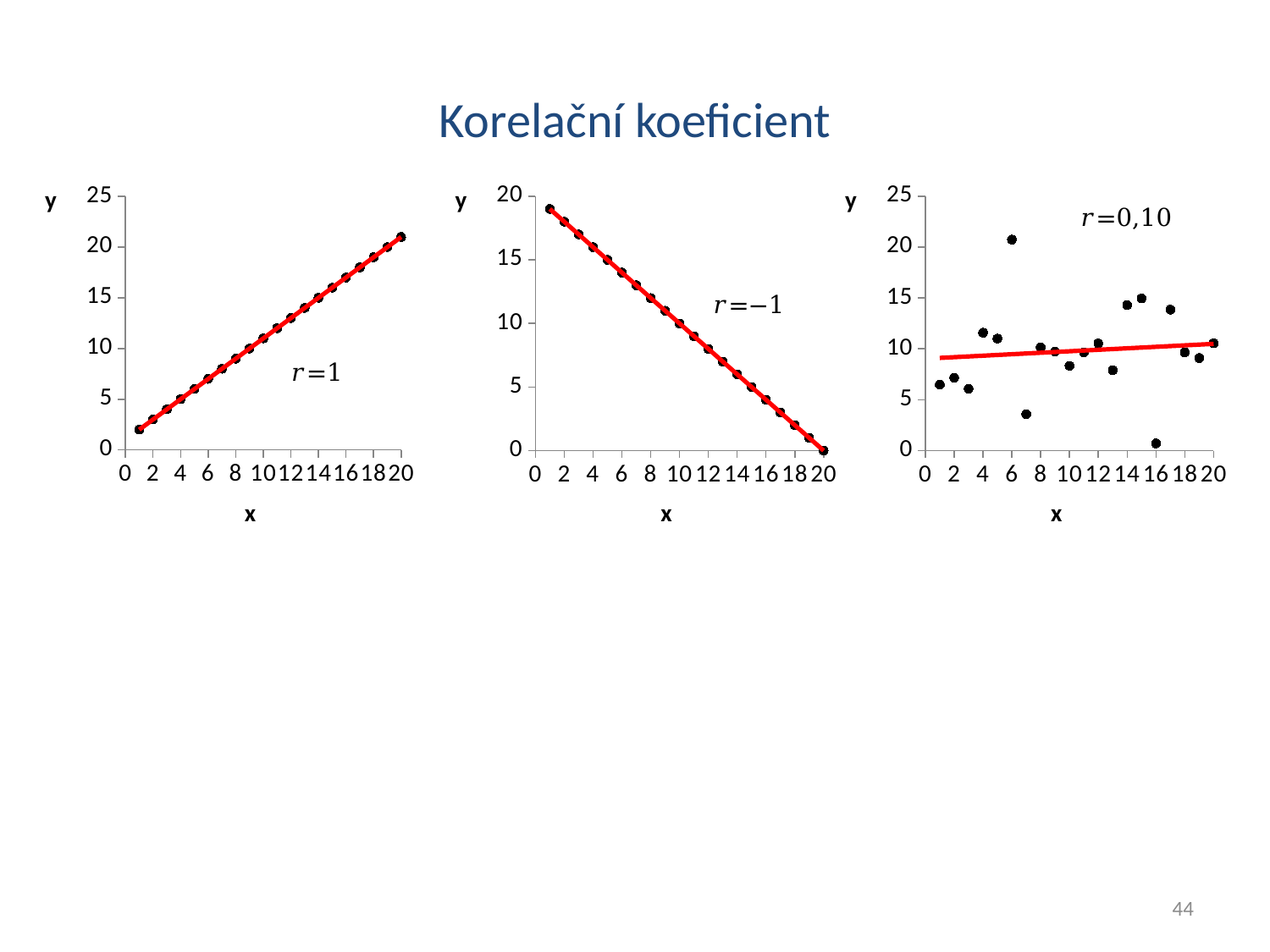
In the left chart (r=1), do the y values rise or fall as x increases? rise In the right chart (r=0,10), at which x value is the highest y value plotted? 6 What kind of chart is the left chart (r=1)? scatter chart What correlation coefficient is annotated on the right chart? r=0,10 In the right chart (r=0,10), which point has a larger y value: the one at x=6 or the one at x=7? x=6 In the middle chart (r=-1), do the y values rise or fall as x increases? fall In the middle chart (r=-1), is the y value at x=18 greater or less than 5? less In the middle chart (r=-1), is the y value at x=2 greater or less than 15? greater In the right chart (r=0,10), is the y value at x=16 greater or less than 5? less What is the title of the slide containing the three charts? Korelační koeficient In the right chart (r=0,10), at which x value is the lowest y value plotted? 16